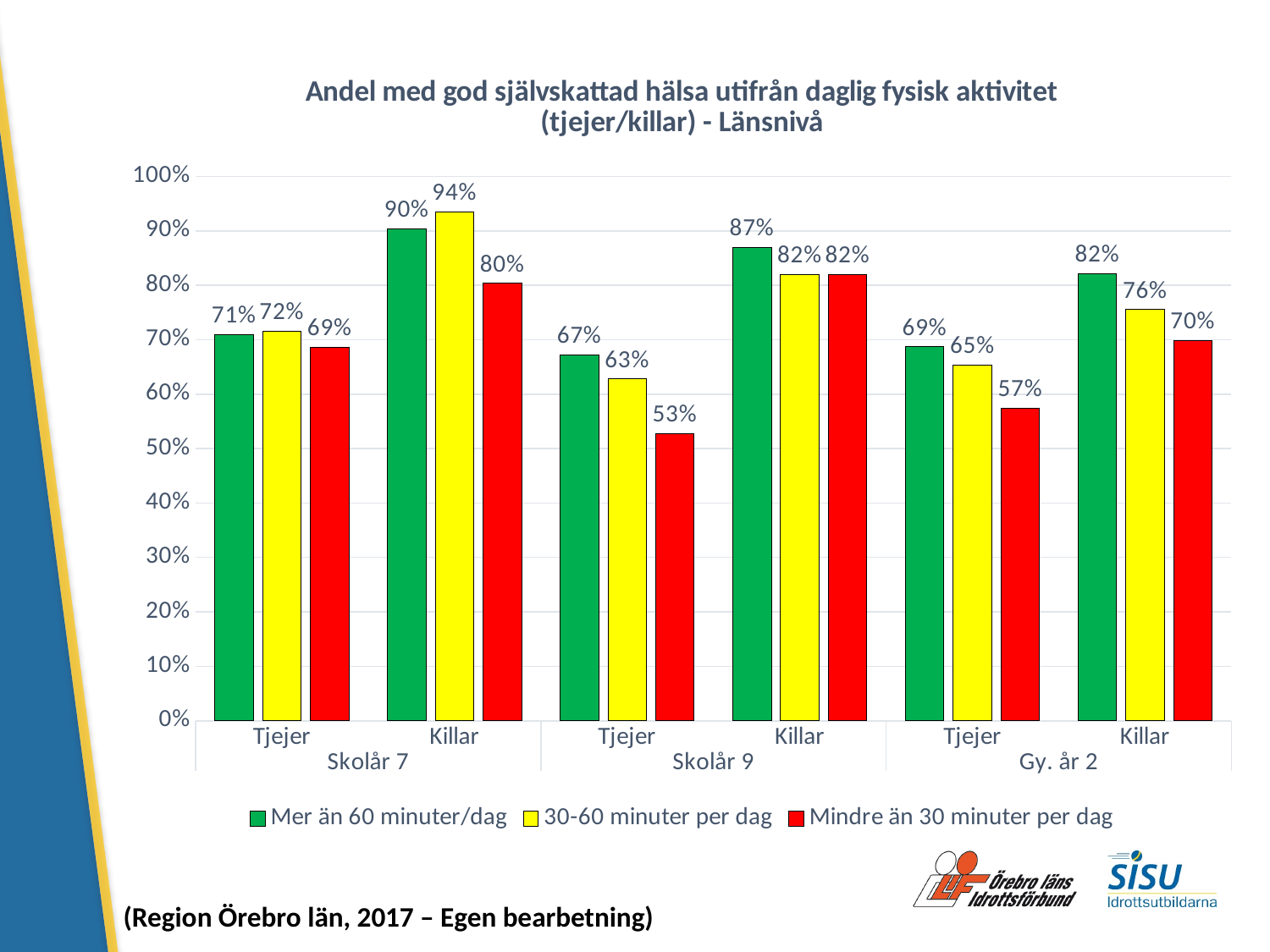
What is the value for 'Mer än 60 minuter/dag' among Killar in Skolår 7? 90% What kind of chart is shown on the slide? Bar chart Which group has the lowest value for 'Mindre än 30 minuter per dag'? Tjejer, Skolår 9 What is the difference between 'Mer än 60 minuter/dag' and 'Mindre än 30 minuter per dag' for Tjejer in Skolår 9? 14 percentage points What is the value for 'Mindre än 30 minuter per dag' among Tjejer in Skolår 9? 53% Which group has the highest value for '30-60 minuter per dag'? Killar, Skolår 7 Is the value for 'Mindre än 30 minuter per dag' among Killar in Skolår 9 greater or less than 80%? greater What is the value for '30-60 minuter per dag' among Killar in Gy. år 2? 76% Which colour represents 'Mindre än 30 minuter per dag' in the legend? Red Which is larger for Tjejer in Gy. år 2: 'Mer än 60 minuter/dag' or '30-60 minuter per dag'? Mer än 60 minuter/dag How many series does the legend list? 3 How many groups (category bars clusters) are shown on the x axis? 6